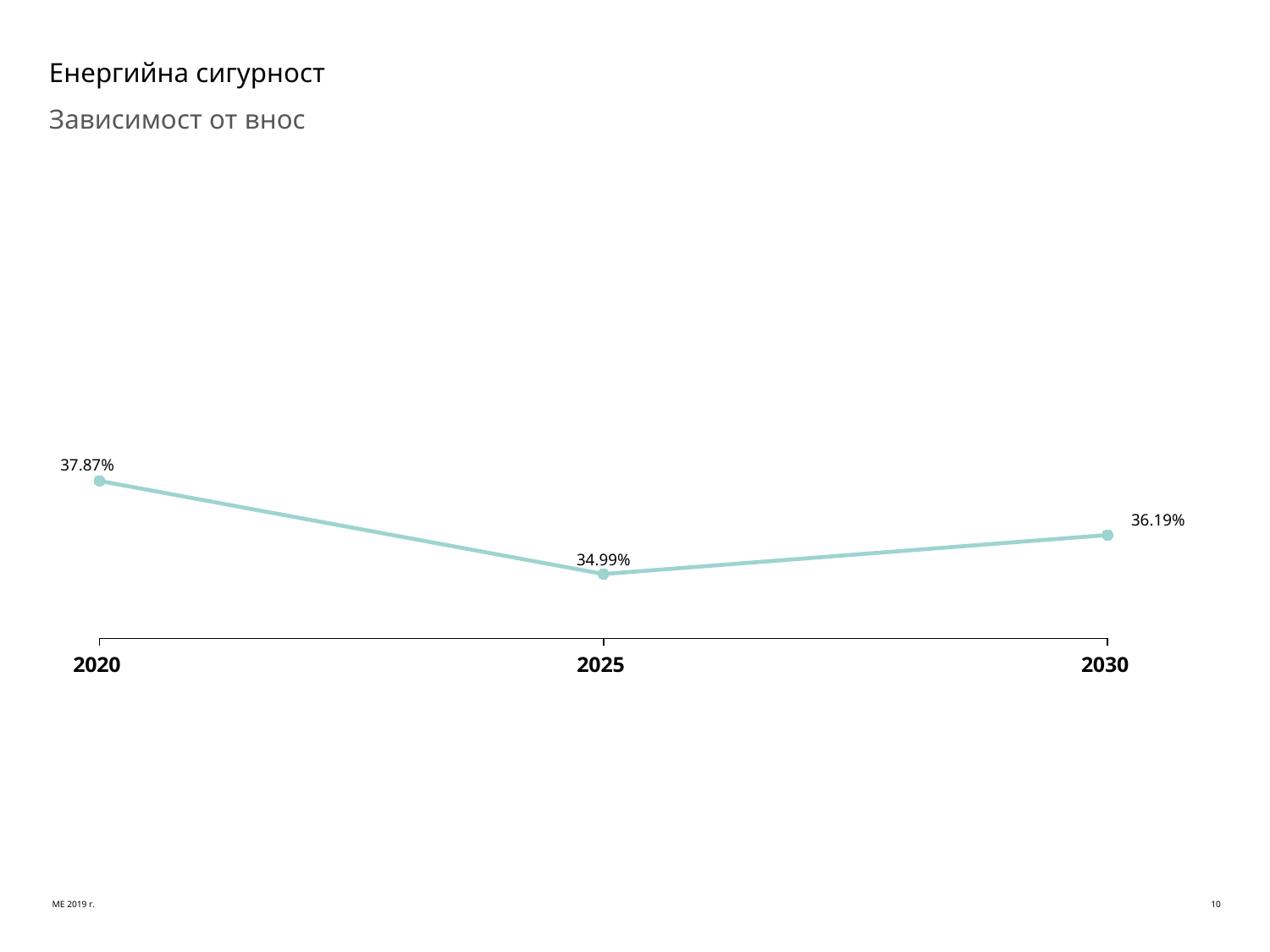
What kind of chart is shown on the slide? Line chart Which is larger, the value for 2020 or the value for 2030? 2020 Which year has the lowest value? 2025 How many data points are plotted on the chart? 3 What is the difference between the values for 2020 and 2025? 2.88% What is the subtitle of the chart on the slide? Зависимост от внос Does the value rise or fall from 2020 to 2025? Fall What is the value for 2020? 37.87% What is the difference between the values for 2030 and 2025? 1.20% What is the value for 2025? 34.99% What is the value for 2030? 36.19% Which year has the highest value? 2020